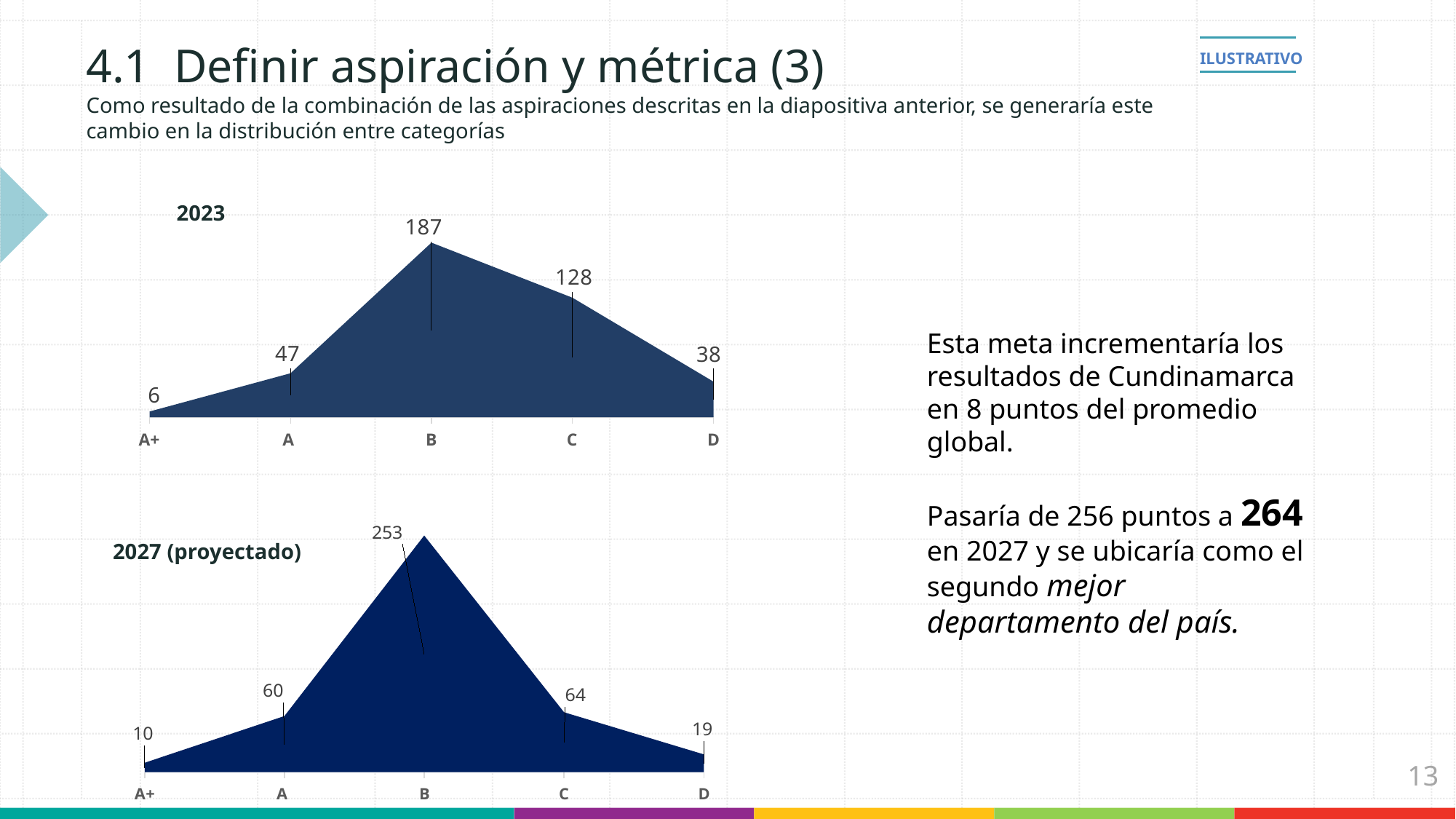
In the 2027 (proyectado) chart, what is the difference between the values for B and A? 193 In the 2023 chart, which category has the highest value? B In the 2023 chart, which category has the lowest value? A+ In the 2027 (proyectado) chart, which category has the lowest value? A+ In the 2023 chart, what is the value for category B? 187 What kind of chart is the 2027 (proyectado) chart? Area chart In the 2027 (proyectado) chart, what is the value for category A? 60 How many categories are shown on the x axis of the 2023 chart? 5 In the 2027 (proyectado) chart, what is the value for category C? 64 In the 2023 chart, what is the difference between the values for B and C? 59 In the 2027 (proyectado) chart, which is larger, the value for A or the value for D? A In the 2023 chart, what is the value for category D? 38